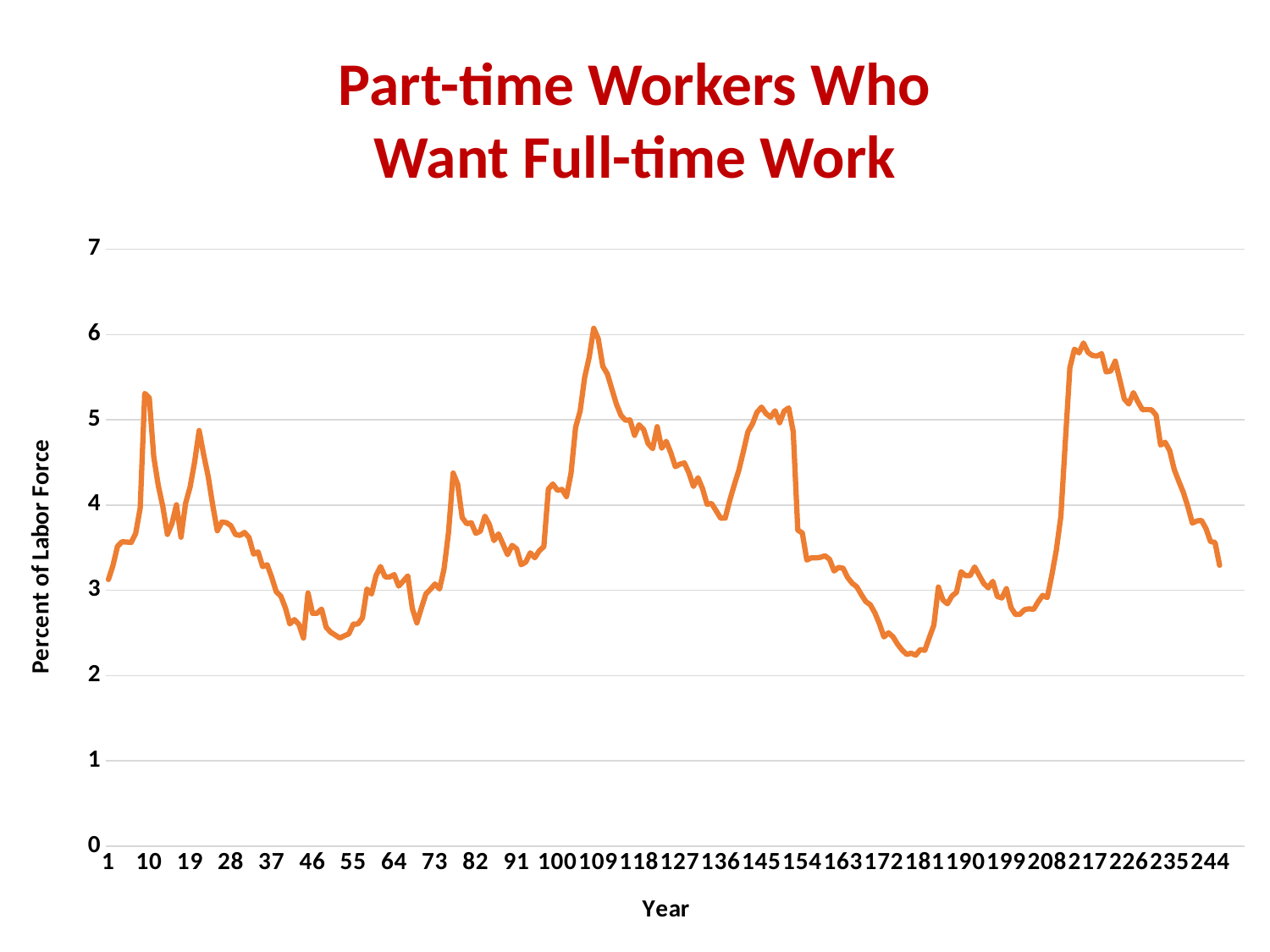
Is the value at year 226 greater or less than 5? greater What is the label on the vertical axis of the chart? Percent of Labor Force What kind of chart is shown on the slide? line chart Between year 217 and year 244, does the line rise or fall? fall Is the value at year 10 greater or less than 5? greater Is the value at year 64 greater or less than 4? less Near which labelled year on the x axis does the line reach its highest value? 109 What is the title of the chart? Part-time Workers Who Want Full-time Work